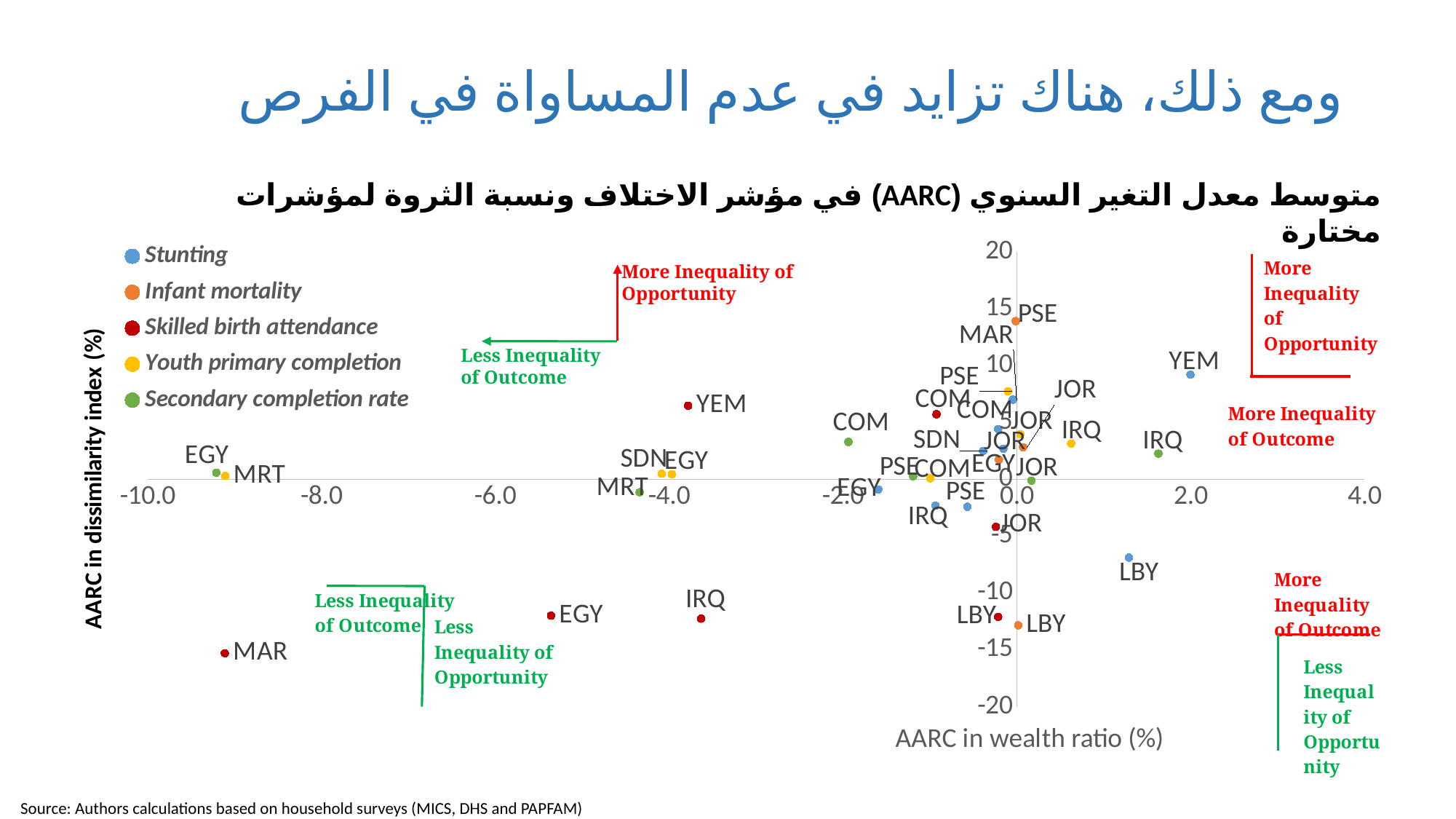
What is the title of the horizontal axis? AARC in wealth ratio (%) Is the AARC in wealth ratio for the Stunting point labelled YEM greater or less than 1.0? greater Is the AARC in dissimilarity index for the Stunting point labelled LBY greater or less than -5? less How many series does the legend list? 5 Which Skilled birth attendance point has the lowest AARC in wealth ratio? MAR What kind of chart is shown on the slide? Scatter chart Among the Skilled birth attendance points, which has the higher AARC in dissimilarity index: YEM or IRQ? YEM What is the title of the vertical axis? AARC in dissimilarity index (%) Which Stunting point has the highest AARC in dissimilarity index? YEM Is the AARC in wealth ratio for the Skilled birth attendance point labelled MAR greater or less than -8.0? less